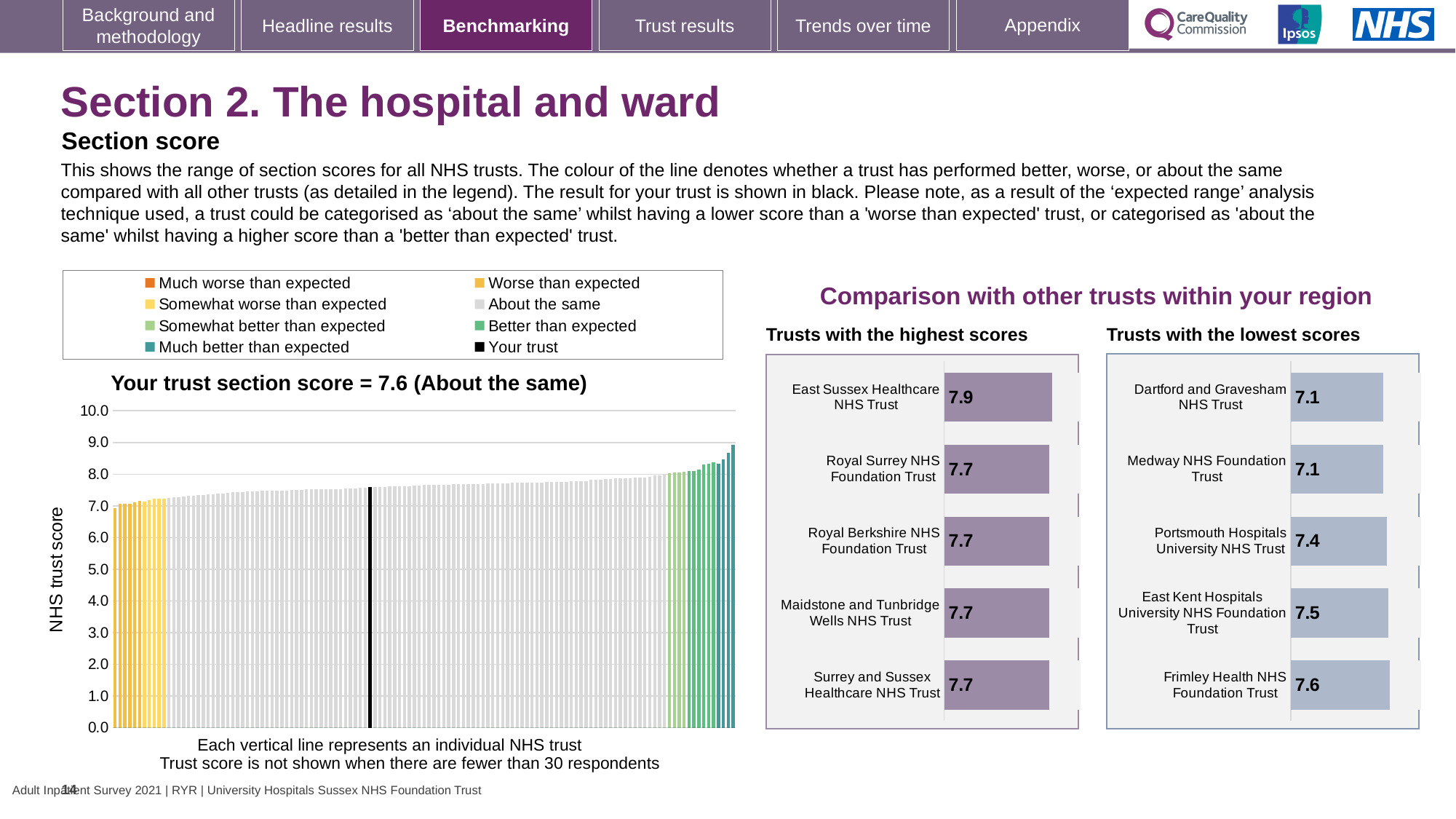
In the 'Trusts with the lowest scores' chart, which trust has the highest score? Frimley Health NHS Foundation Trust In the 'Trusts with the highest scores' chart, which trust has the highest score? East Sussex Healthcare NHS Trust In the 'Your trust section score' chart, what category is your trust placed in? About the same What kind of chart is the 'Your trust section score' chart? bar chart In the 'Your trust section score' chart, do the trust scores rise or fall from left to right? rise In the 'Trusts with the lowest scores' chart, what is the difference between the scores of Frimley Health NHS Foundation Trust and Dartford and Gravesham NHS Trust? 0.5 In the 'Trusts with the lowest scores' chart, what is the score for Portsmouth Hospitals University NHS Trust? 7.4 In the 'Your trust section score' chart, what is the section score for your trust? 7.6 In the 'Your trust section score' chart, what colour is used for your trust? black In the 'Trusts with the highest scores' chart, what is the difference between the scores of East Sussex Healthcare NHS Trust and Royal Surrey NHS Foundation Trust? 0.2 In the 'Trusts with the highest scores' chart, what is the score for East Sussex Healthcare NHS Trust? 7.9 In the 'Trusts with the highest scores' chart, how many trusts are shown? 5